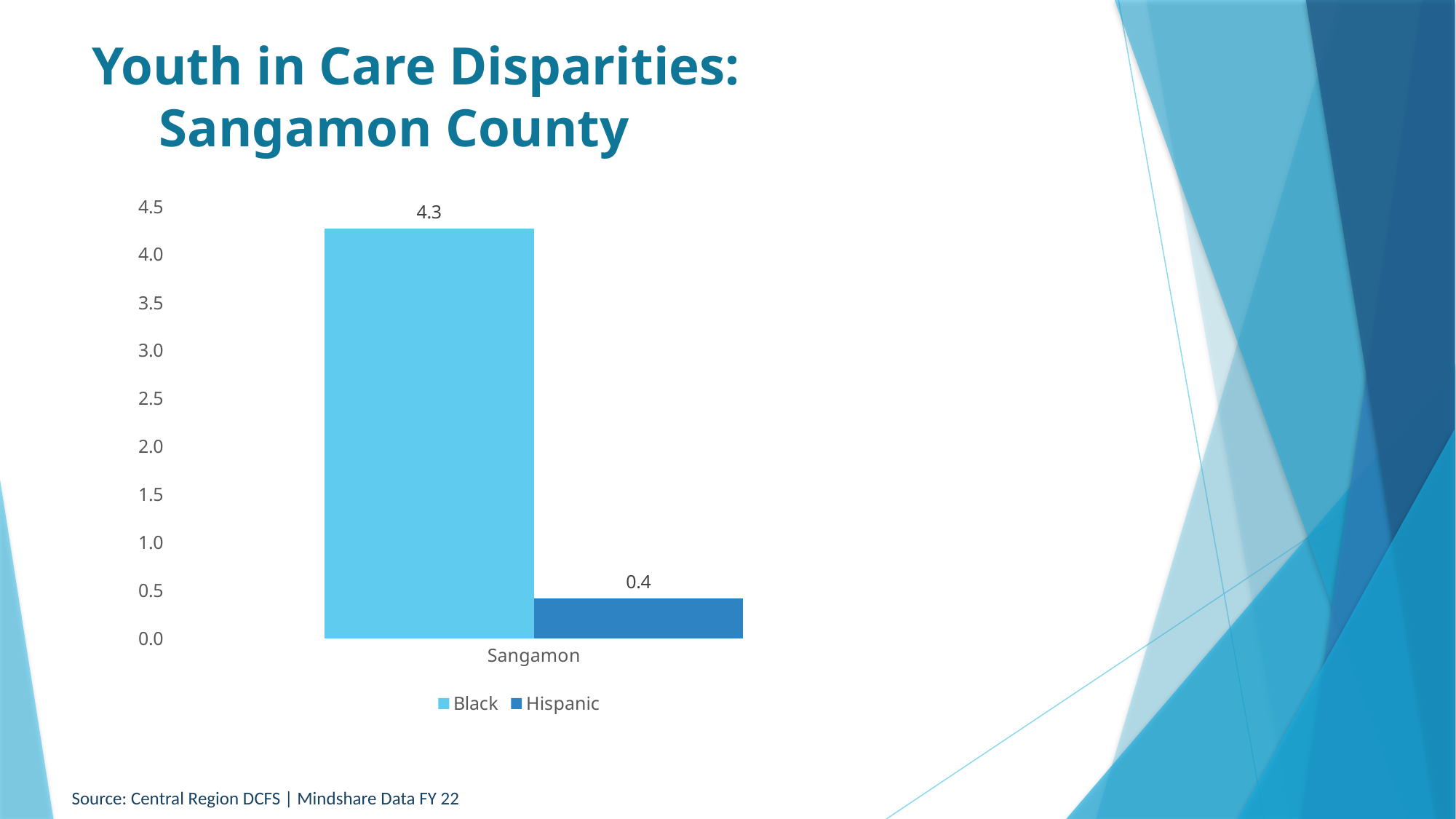
What is the value for Hispanic in Sangamon? 0.4 What is the difference between the Black and Hispanic values for Sangamon? 3.9 Which series has the higher value for Sangamon, Black or Hispanic? Black What is the value for Black in Sangamon? 4.3 Is the value for Hispanic in Sangamon greater or less than 1.0? less Is the value for Black in Sangamon greater or less than 4.0? greater What is the highest value shown on the y axis? 4.5 How many categories are shown on the x axis? 1 What is the category label on the x axis? Sangamon Which series has the lowest value in the chart? Hispanic How many series does the legend list? 2 What kind of chart is shown on the slide? Bar chart